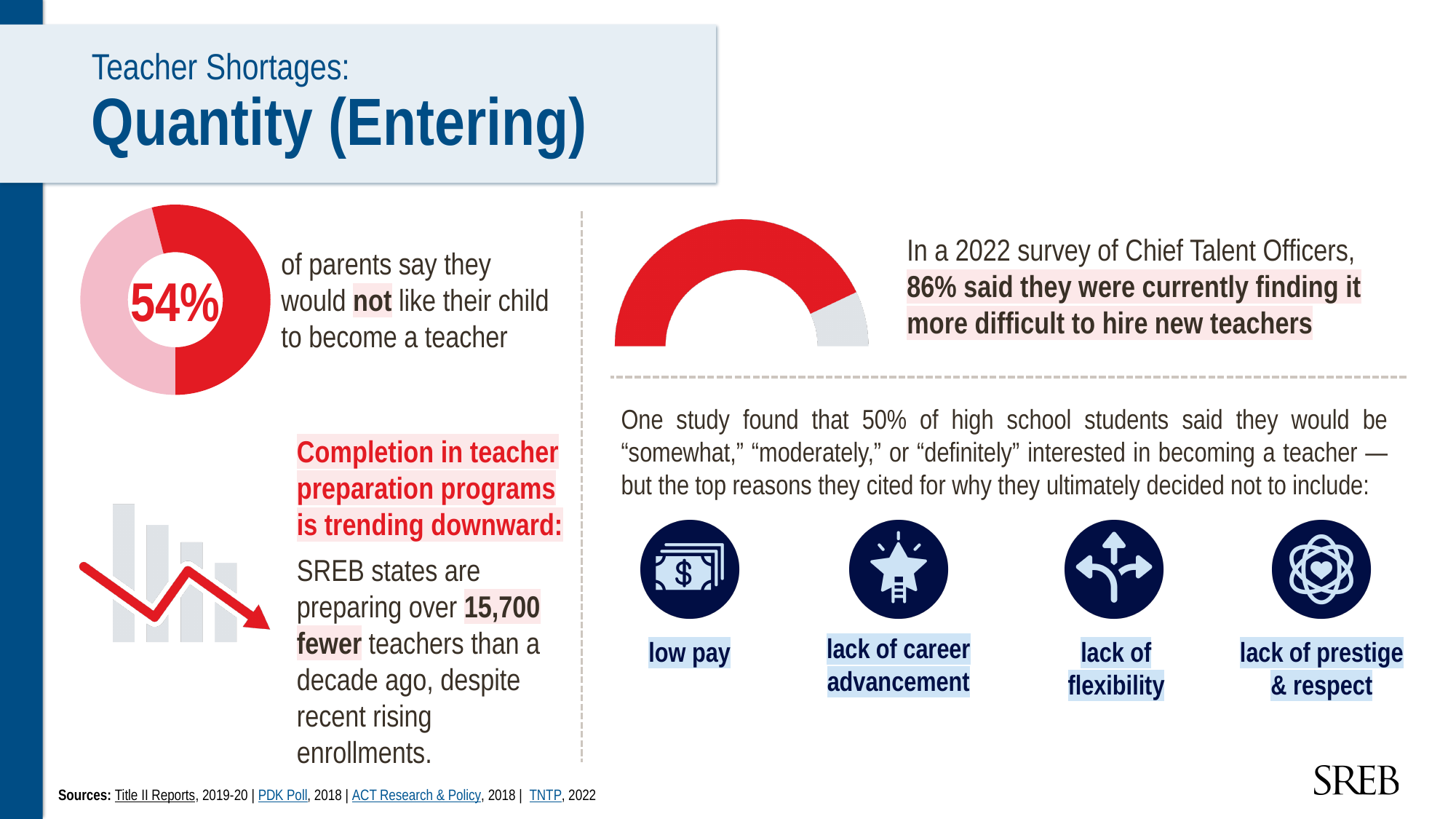
How many bars are drawn in the small bar chart with the red arrow at the bottom left? 4 What percentage does the red semicircle gauge on the right of the slide represent? 86% In the donut chart on the left, is the dark red segment greater or less than 50% of the circle? greater What percentage is shown in the centre of the donut chart on the left of the slide? 54% In the semicircle gauge on the right, is the red filled portion greater or less than 75%? greater Which is larger: the 54% shown in the donut chart or the 86% shown in the semicircle gauge? 86% (semicircle gauge) What is the difference between the 86% in the semicircle gauge and the 54% in the donut chart? 32 percentage points In the donut chart on the left, what share of the circle is not covered by the dark red segment (i.e., parents not in the 54% group)? 46% What kind of chart is used to show the share of parents who would not like their child to become a teacher? donut (pie) chart What colour is the filled segment of the semicircle gauge on the right of the slide? red In the donut chart on the left, what share of parents say they would not like their child to become a teacher? 54% In the small bar chart with the red arrow at the bottom left, do the bars rise or fall from left to right? fall